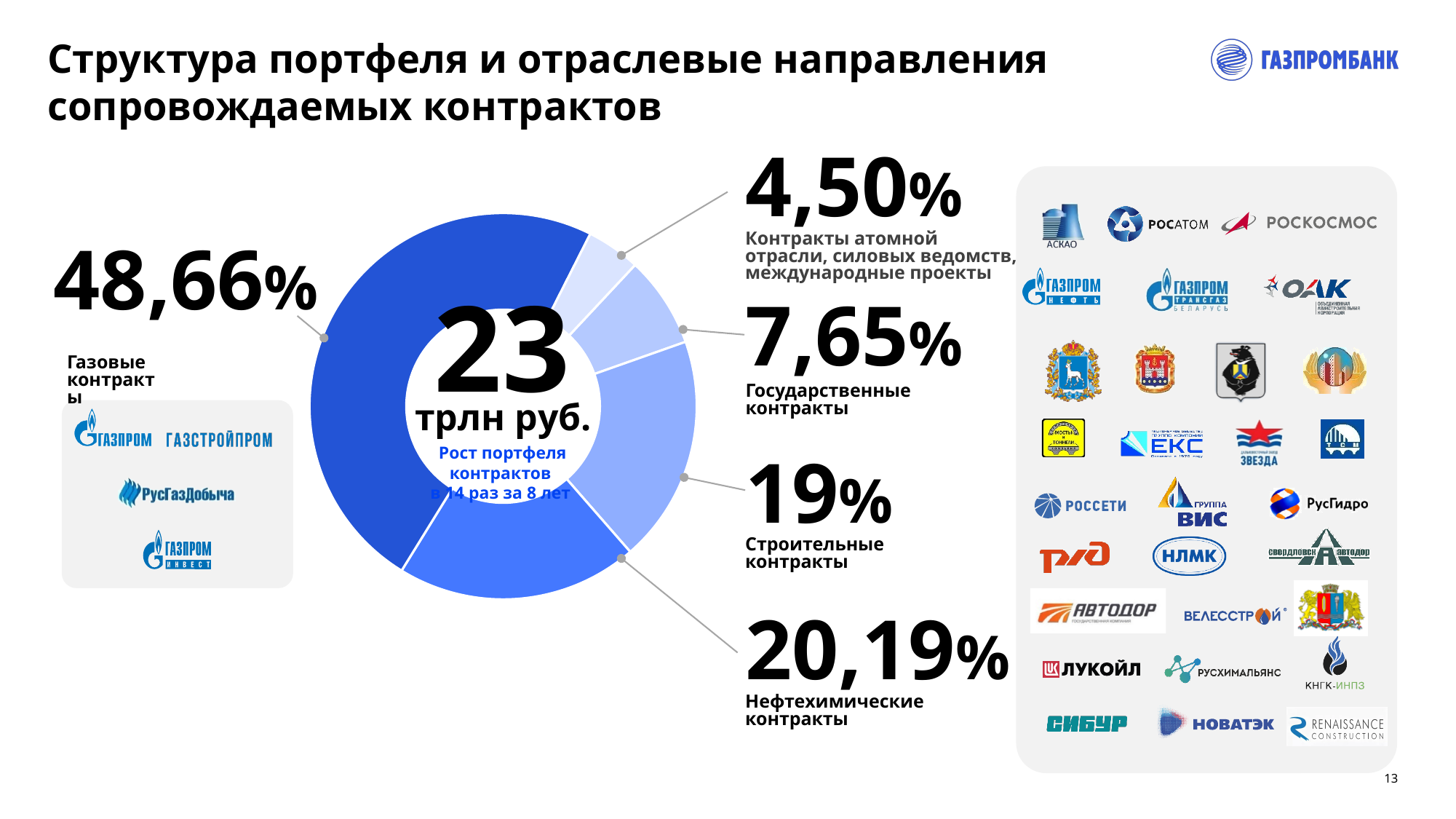
How many categories are shown in the donut chart? 5 What total value is shown in the centre of the donut chart? 23 трлн руб. What share of the portfolio do construction contracts (Строительные контракты) account for? 19% Which category has the smallest share of the portfolio? Контракты атомной отрасли, силовых ведомств, международные проекты What share of the portfolio do government contracts (Государственные контракты) account for? 7,65% What share of the portfolio do nuclear industry, security agency and international project contracts account for? 4,50% What share of the portfolio do gas contracts (Газовые контракты) account for? 48,66% What is the difference in share between gas contracts and petrochemical contracts? 28,47 percentage points What share of the portfolio do petrochemical contracts (Нефтехимические контракты) account for? 20,19% What kind of chart is shown on the slide? Donut (pie) chart Which share is larger: petrochemical contracts or construction contracts? Нефтехимические контракты (20,19%) Which category has the largest share of the portfolio? Газовые контракты